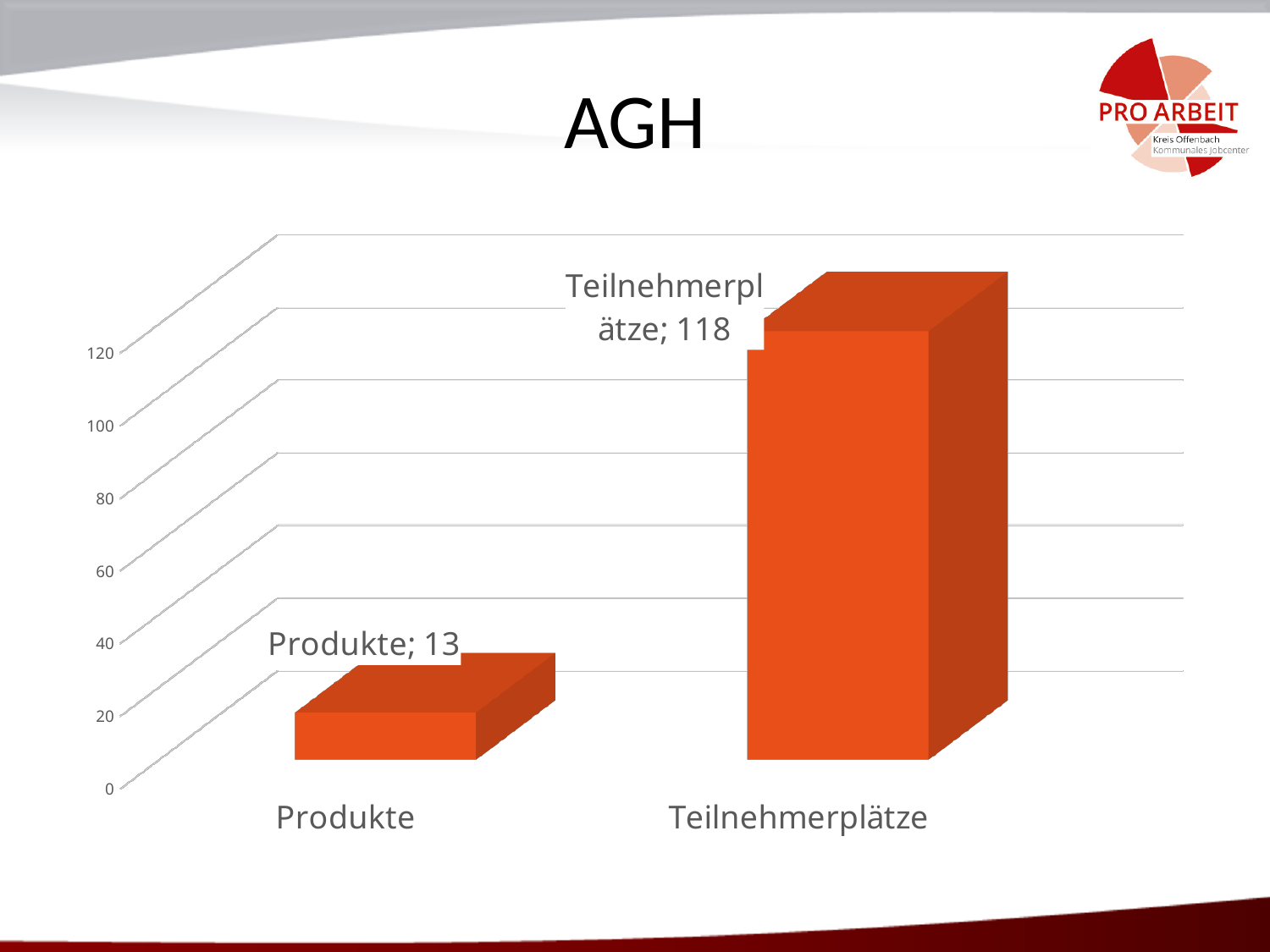
What is the value for Teilnehmerplätze? 118 Is the value for Teilnehmerplätze greater or less than 100? greater Is the value for Produkte greater or less than 20? less Which category has the lowest value? Produkte How many categories are shown on the chart? 2 What is the difference between the values for Teilnehmerplätze and Produkte? 105 What is the value for Produkte? 13 Which category has the highest value? Teilnehmerplätze Which is larger, the value for Produkte or the value for Teilnehmerplätze? Teilnehmerplätze What is the title of the slide? AGH What kind of chart is shown on the slide? bar chart What is the highest value shown on the vertical axis? 120